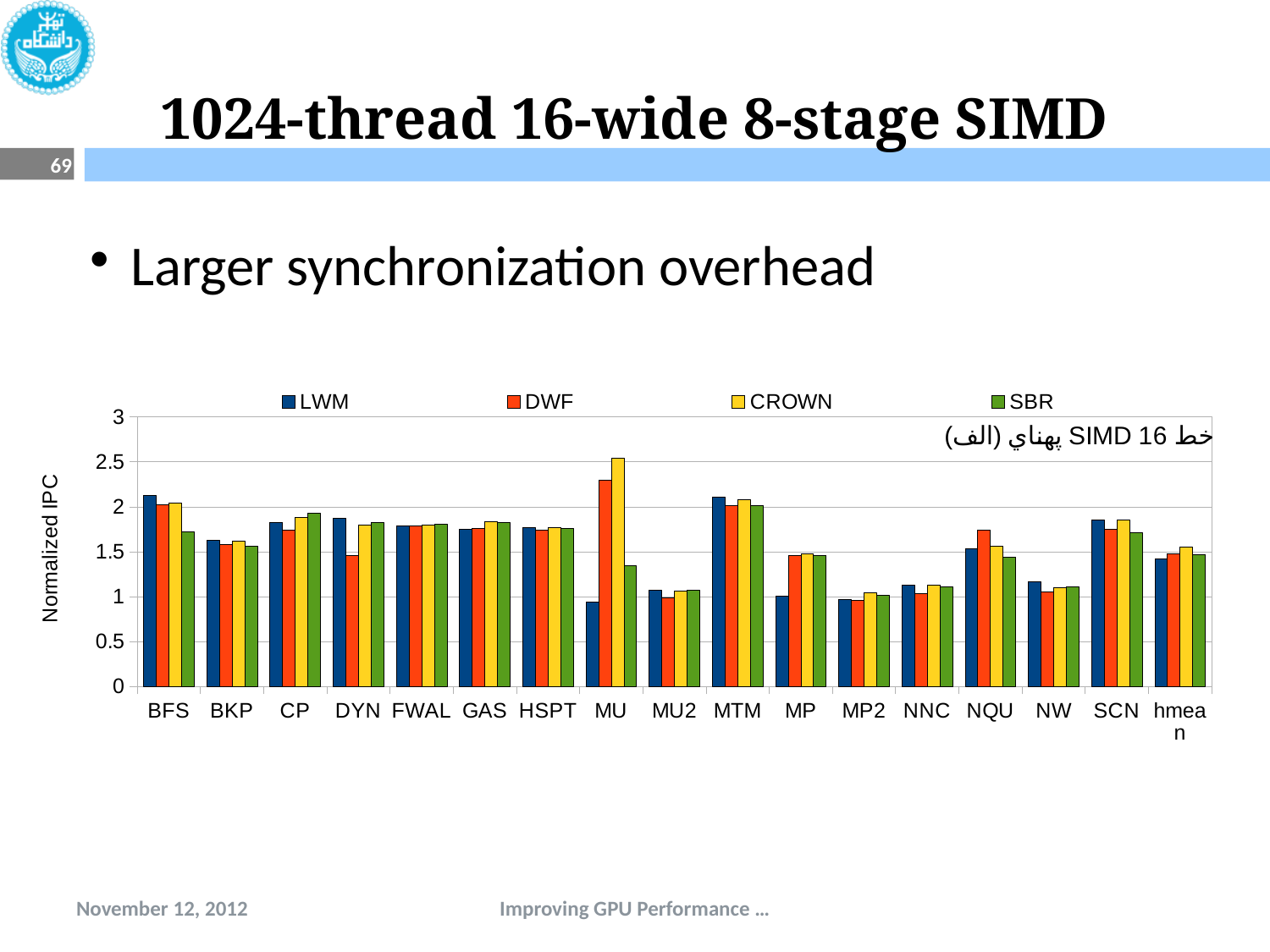
How many categories are shown along the x axis of the chart? 17 For BFS, which is larger: the LWM value or the SBR value? LWM What kind of chart is shown on the slide? bar chart Is the CROWN value for MU greater or less than 2? greater Which series has the lowest value for MU? LWM Is the SBR value for BFS greater or less than 2? less For DYN, which is larger: the LWM value or the DWF value? LWM For which category is the CROWN value highest? MU Is the DWF value for NQU greater or less than 1.5? greater What is the label of the y axis of the chart? Normalized IPC Which series has the highest value for MU? CROWN How many series does the chart's legend list? 4